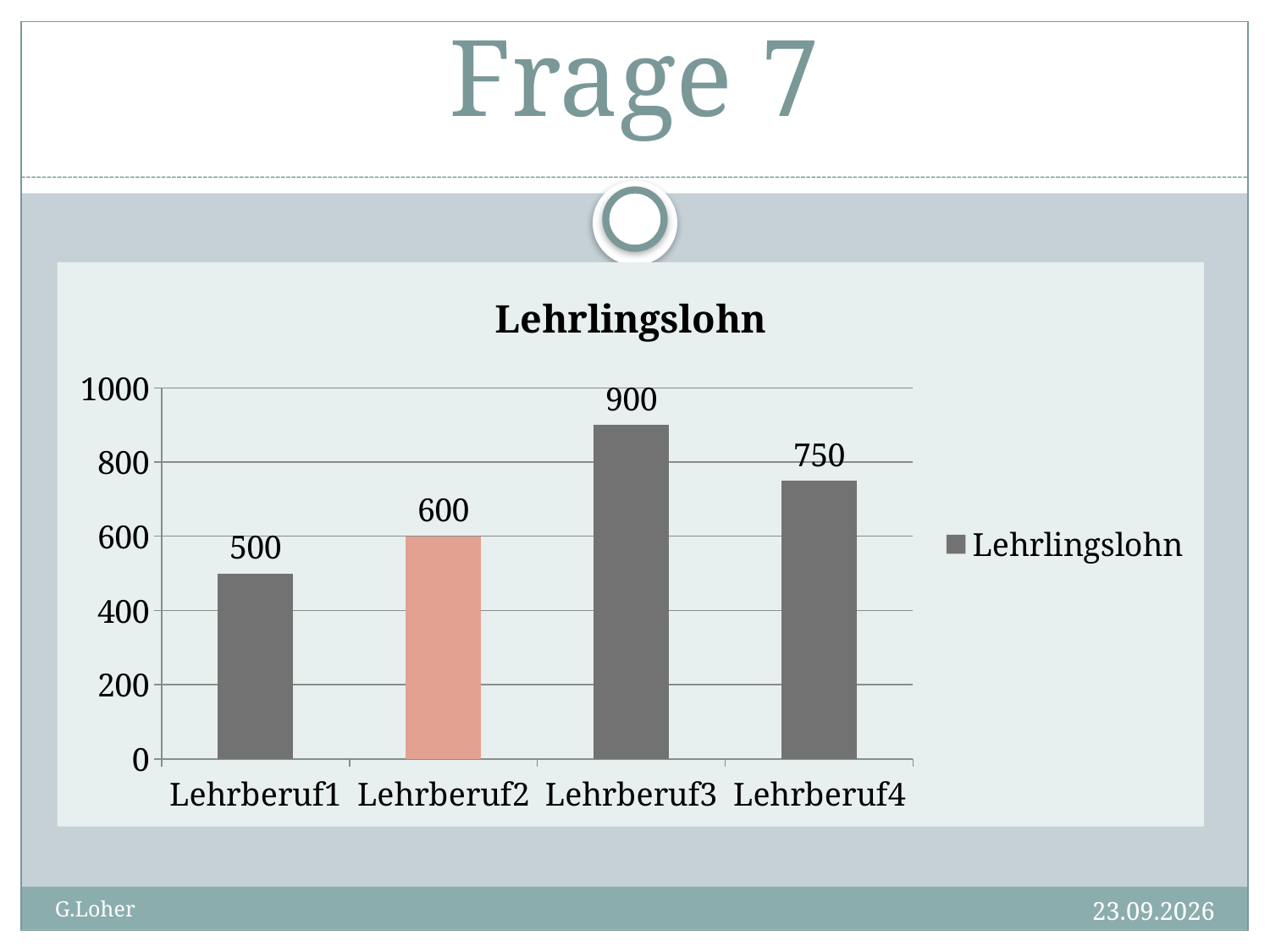
How many categories are shown on the x axis? 4 What is the value for Lehrberuf4? 750 How many series does the legend list? 1 What kind of chart is shown? bar chart Which category has the highest value? Lehrberuf3 What is the value for Lehrberuf1? 500 What is the value for Lehrberuf3? 900 Which is larger, the value for Lehrberuf2 or the value for Lehrberuf4? Lehrberuf4 What is the difference between the values for Lehrberuf4 and Lehrberuf1? 250 What is the difference between the values for Lehrberuf3 and Lehrberuf2? 300 Which category has the lowest value? Lehrberuf1 What is the title of the chart? Lehrlingslohn